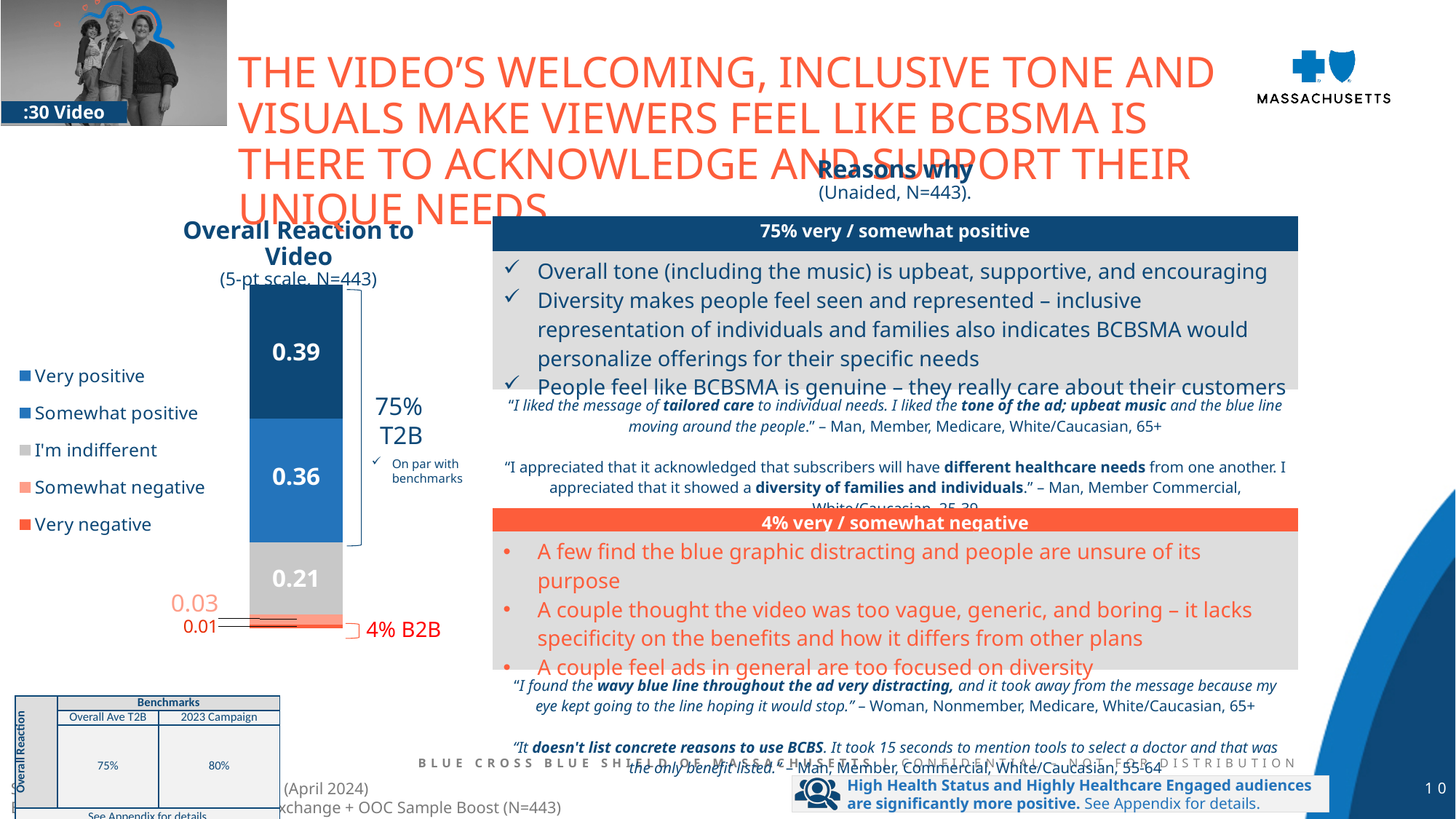
What is the difference between the Very positive and Somewhat positive values in the Overall Reaction to Video chart? 0.03 What is the combined total of Very positive and Somewhat positive in the Overall Reaction to Video chart? 0.75 What is the value for Very positive in the Overall Reaction to Video chart? 0.39 Which response category has the highest value in the Overall Reaction to Video chart? Very positive What kind of chart is the Overall Reaction to Video chart? Stacked bar chart Which response category has the lowest value in the Overall Reaction to Video chart? Very negative What is the value for Somewhat negative in the Overall Reaction to Video chart? 0.03 What is the value for Very negative in the Overall Reaction to Video chart? 0.01 What is the value for Somewhat positive in the Overall Reaction to Video chart? 0.36 In the Overall Reaction to Video chart, which is larger: I'm indifferent or Somewhat negative? I'm indifferent How many series does the legend of the Overall Reaction to Video chart list? 5 What is the value for I'm indifferent in the Overall Reaction to Video chart? 0.21